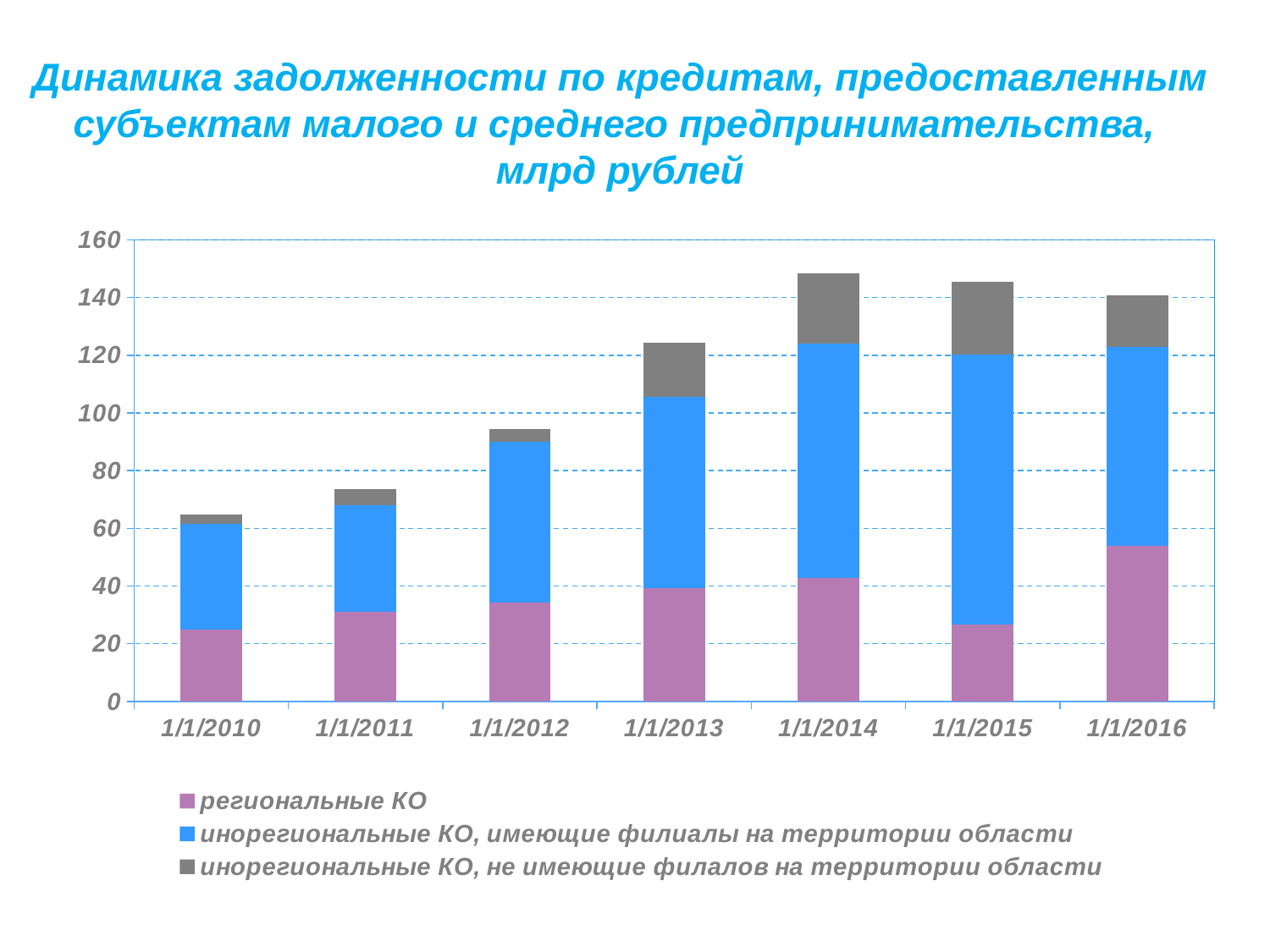
Is the total bar for 1/1/2014 greater or less than 140? greater Which date has the lowest total bar? 1/1/2010 Do the total bars rise or fall from 1/1/2010 to 1/1/2014? rise Is the value for региональные КО on 1/1/2016 greater or less than 40? greater On which date is the value for региональные КО the highest? 1/1/2016 What kind of chart is shown on the slide? Stacked bar chart How many series does the legend list? 3 Is the total bar for 1/1/2012 greater or less than 100? less Which has the larger total bar, 1/1/2012 or 1/1/2013? 1/1/2013 How many dates are shown along the x axis of the chart? 7 What colour represents региональные КО in the chart? Purple